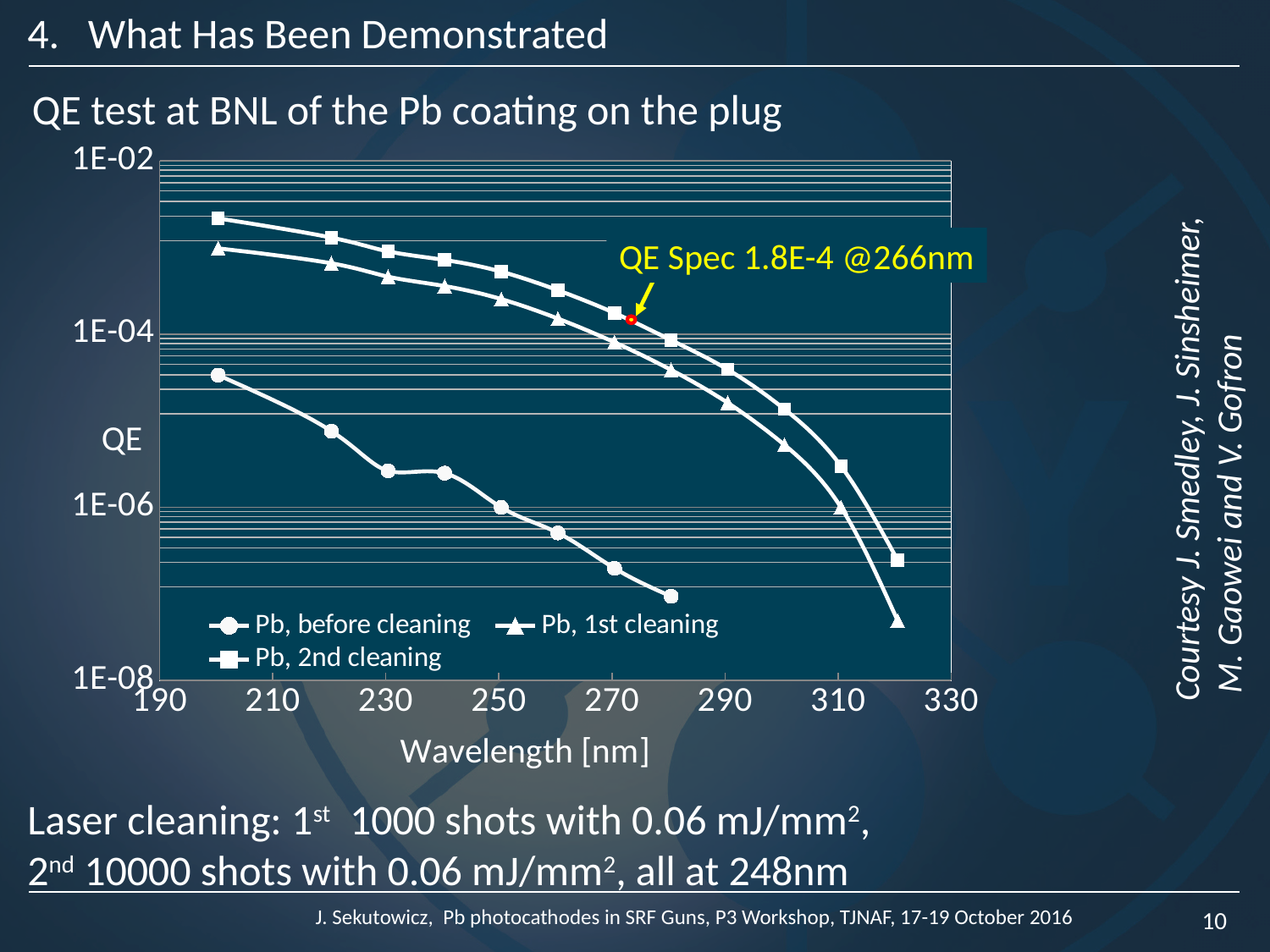
Which series has the highest QE values across the wavelength range? Pb, 2nd cleaning What kind of chart is shown on the slide? line chart What QE specification value is annotated on the chart, and at which wavelength? 1.8E-4 @266nm At 200 nm, which series has the larger QE: 'Pb, before cleaning' or 'Pb, 2nd cleaning'? Pb, 2nd cleaning How many data points are plotted for the 'Pb, before cleaning' series? 8 Does the QE for 'Pb, 2nd cleaning' rise or fall as wavelength increases? fall Is the QE for 'Pb, before cleaning' at 280 nm greater or less than 1E-06? less How many series does the legend list? 3 Which series has the lowest QE values across the wavelength range? Pb, before cleaning Is the QE for 'Pb, before cleaning' at 200 nm greater or less than 1E-04? less Is the QE for 'Pb, 2nd cleaning' at 200 nm greater or less than 1E-04? greater What is the label of the x axis? Wavelength [nm]